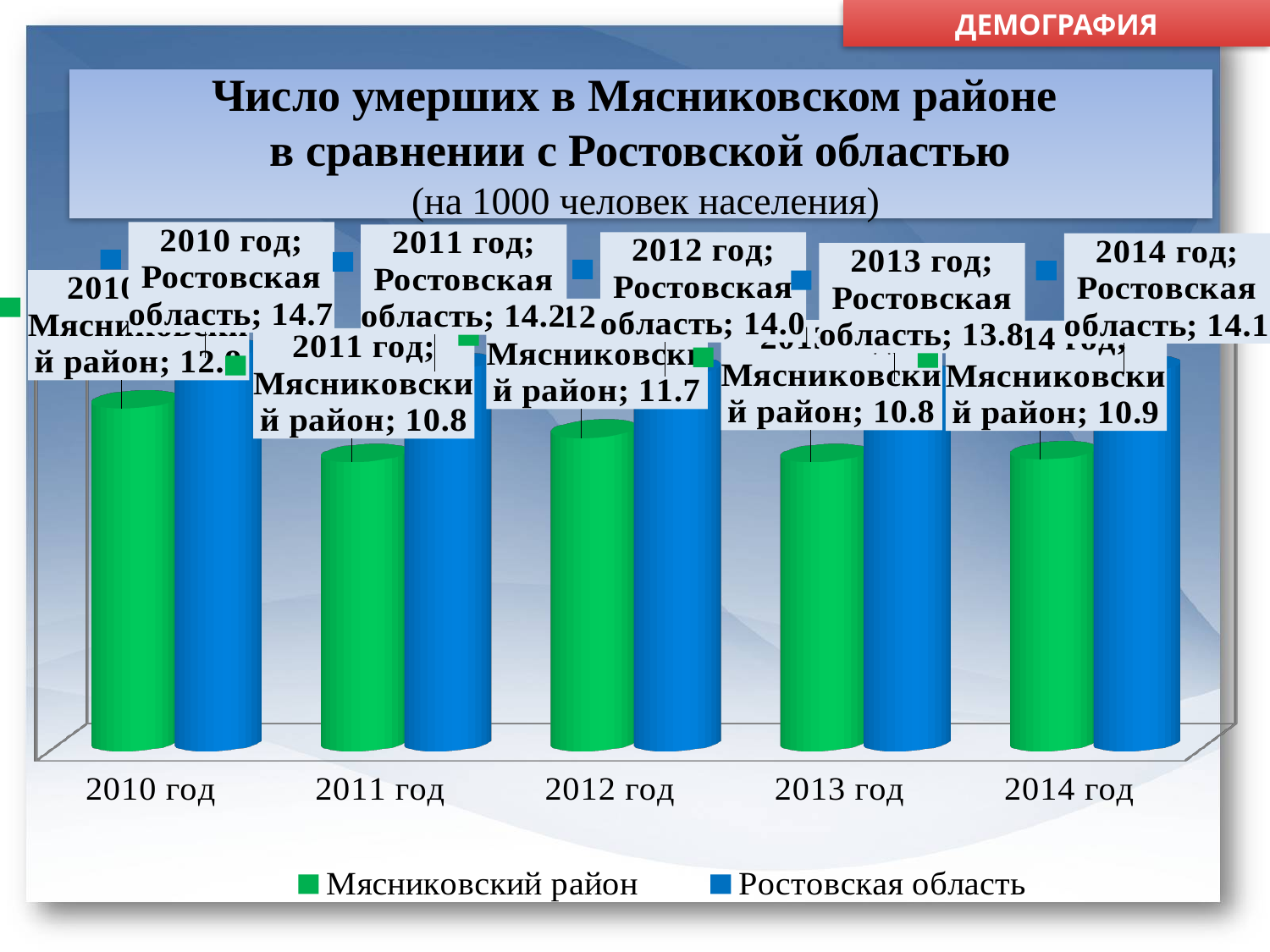
In which year is the value for Мясниковский район the highest? 2010 год What is the difference between Ростовская область and Мясниковский район in 2012 год? 2.3 In which year is the value for Ростовская область the lowest? 2013 год How many series does the legend list? 2 How many years are shown on the x axis? 5 What value is shown for Мясниковский район in 2012 год? 11.7 In which year is the value for Ростовская область the highest? 2010 год What value is shown for Ростовская область in 2013 год? 13.8 What kind of chart is shown on the slide? Bar chart What value is shown for Ростовская область in 2011 год? 14.2 What value is shown for Мясниковский район in 2014 год? 10.9 Which is larger in 2014 год: Мясниковский район or Ростовская область? Ростовская область